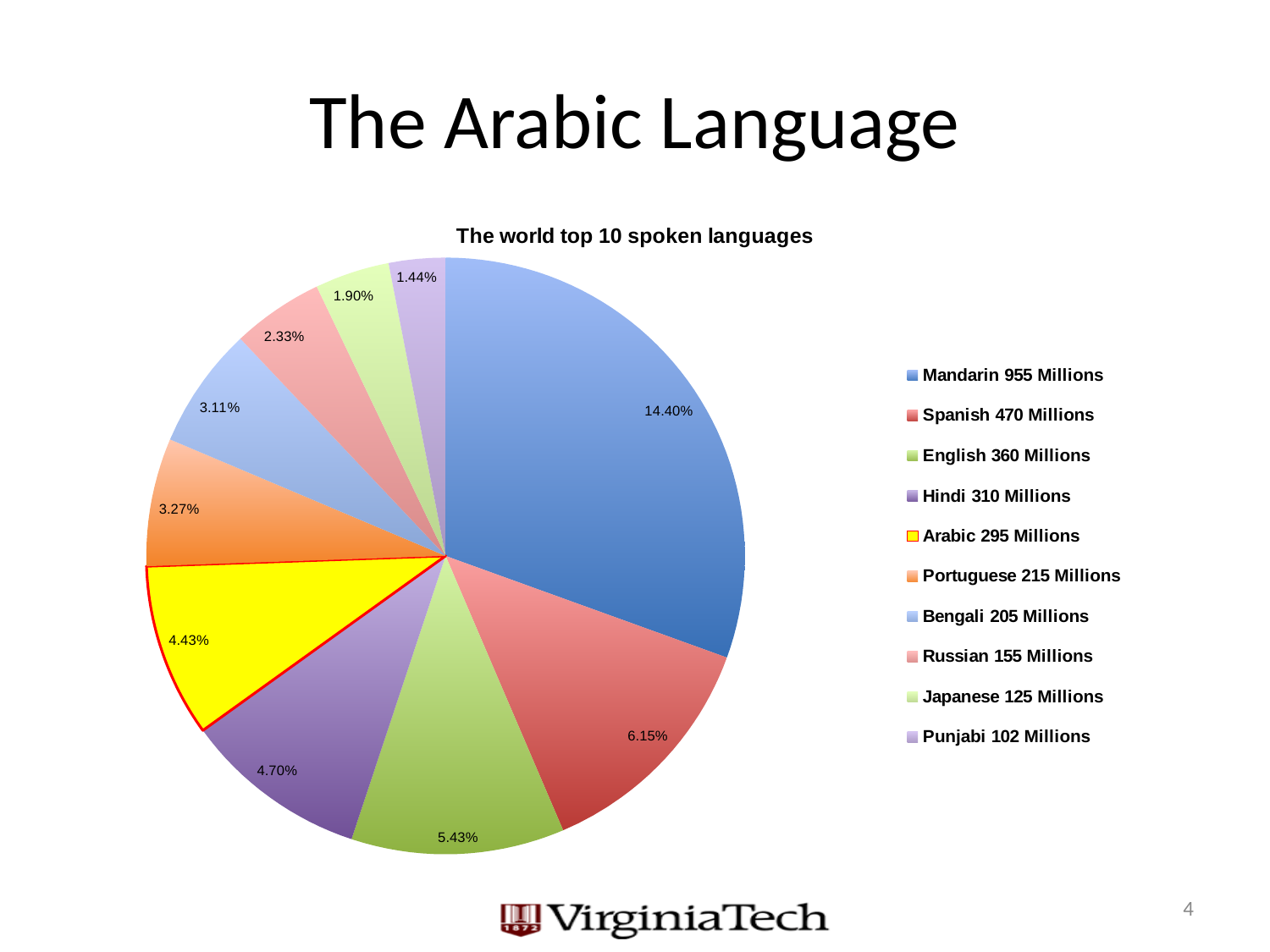
Which slice is larger, Hindi or Arabic? Hindi What percentage label is shown on the Punjabi slice? 1.44% What is the title of the chart? The world top 10 spoken languages How many slices does the pie chart have? 10 What percentage label is shown on the Mandarin slice? 14.40% Which language has the smallest slice in the pie chart? Punjabi What percentage label is shown on the Spanish slice? 6.15% What percentage label is shown on the Arabic slice? 4.43% Which language has the largest slice in the pie chart? Mandarin What colour is the Arabic slice in the pie chart? yellow What kind of chart is shown on the slide? pie chart According to the legend, how many millions of speakers does Arabic have? 295 Millions